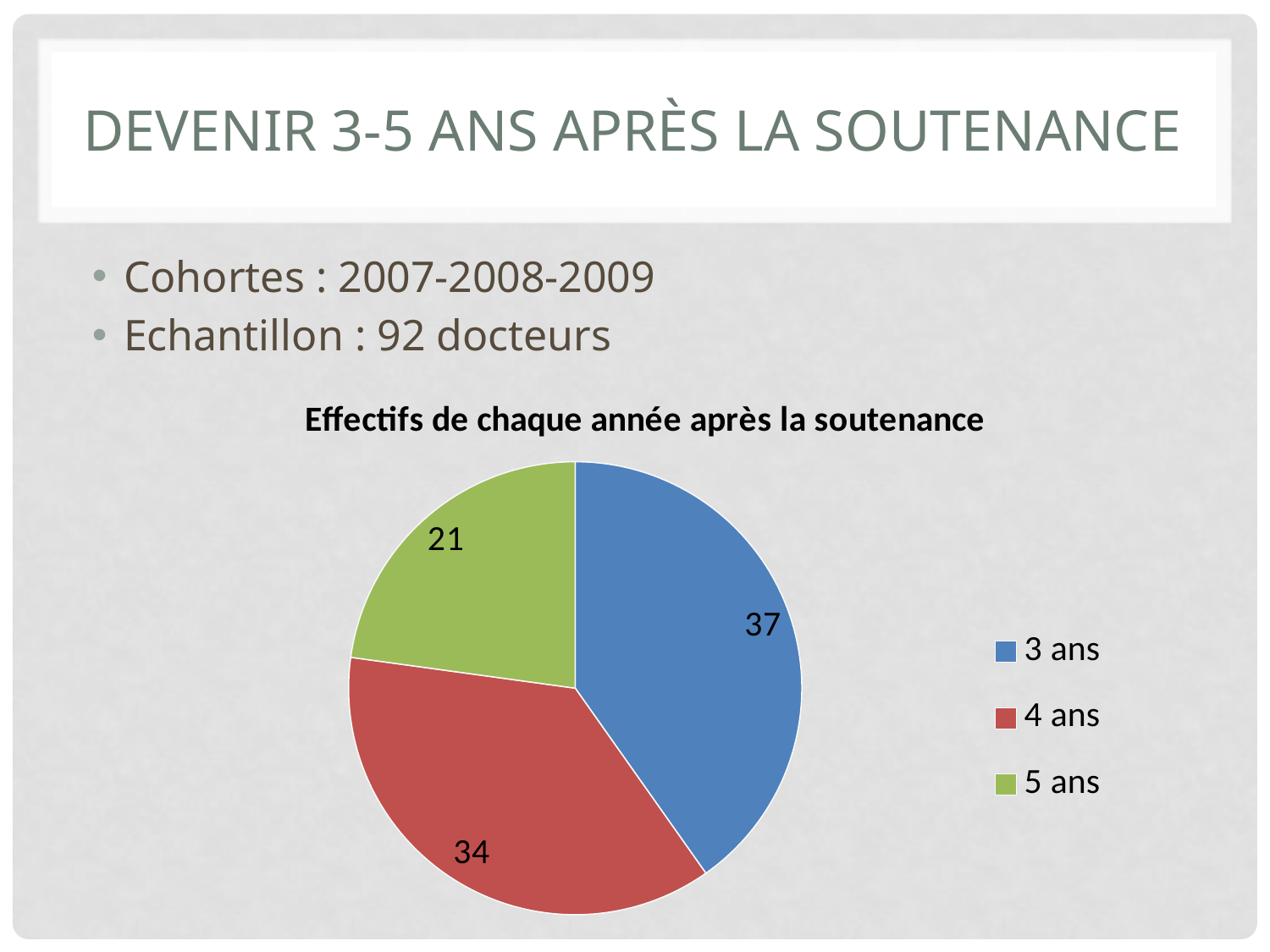
How many slices does the pie chart have? 3 What is the value for the "4 ans" slice? 34 What is the title of the chart? Effectifs de chaque année après la soutenance What is the difference between the values for "3 ans" and "5 ans"? 16 What colour is the "4 ans" slice? red What is the difference between the values for "4 ans" and "5 ans"? 13 What kind of chart is shown on the slide? pie chart Which category has the largest slice? 3 ans Which is larger, the value for "4 ans" or the value for "5 ans"? 4 ans What is the value for the "3 ans" slice? 37 Which category has the smallest slice? 5 ans What is the value for the "5 ans" slice? 21